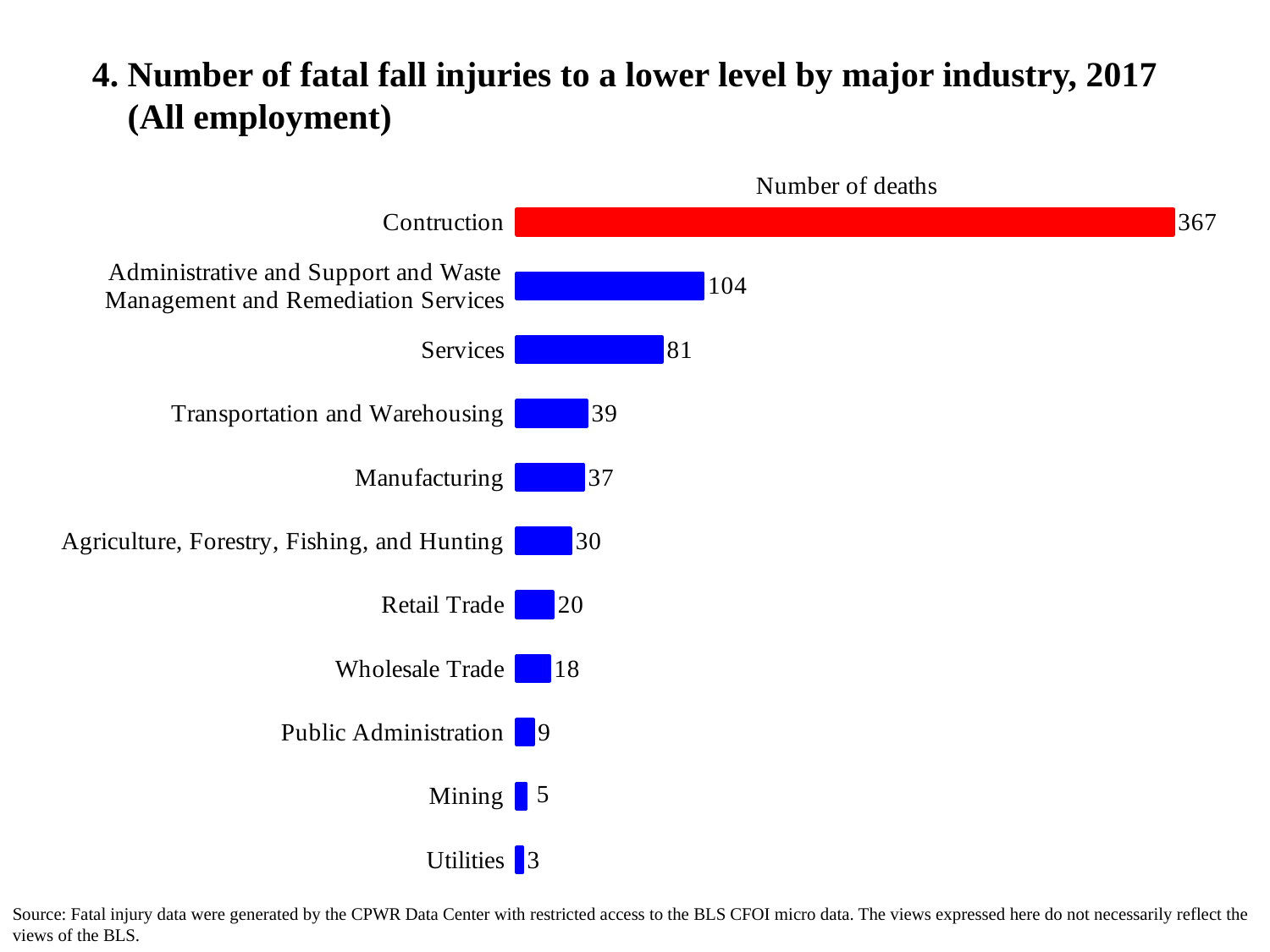
How many fatal fall injuries to a lower level were there in Construction? 367 What is the number of deaths for Services? 81 Which industry has the highest number of deaths? Construction Which industry has the lowest number of deaths? Utilities What is the number of deaths for Administrative and Support and Waste Management and Remediation Services? 104 Which bar is coloured red rather than blue? Construction Which has more deaths, Mining or Public Administration? Public Administration What is the difference in number of deaths between Retail Trade and Wholesale Trade? 2 Which has more deaths, Transportation and Warehousing or Manufacturing? Transportation and Warehousing How many industries are shown in the chart? 11 What type of chart is shown on the slide? Bar chart What is the difference in number of deaths between Construction and Administrative and Support and Waste Management and Remediation Services? 263